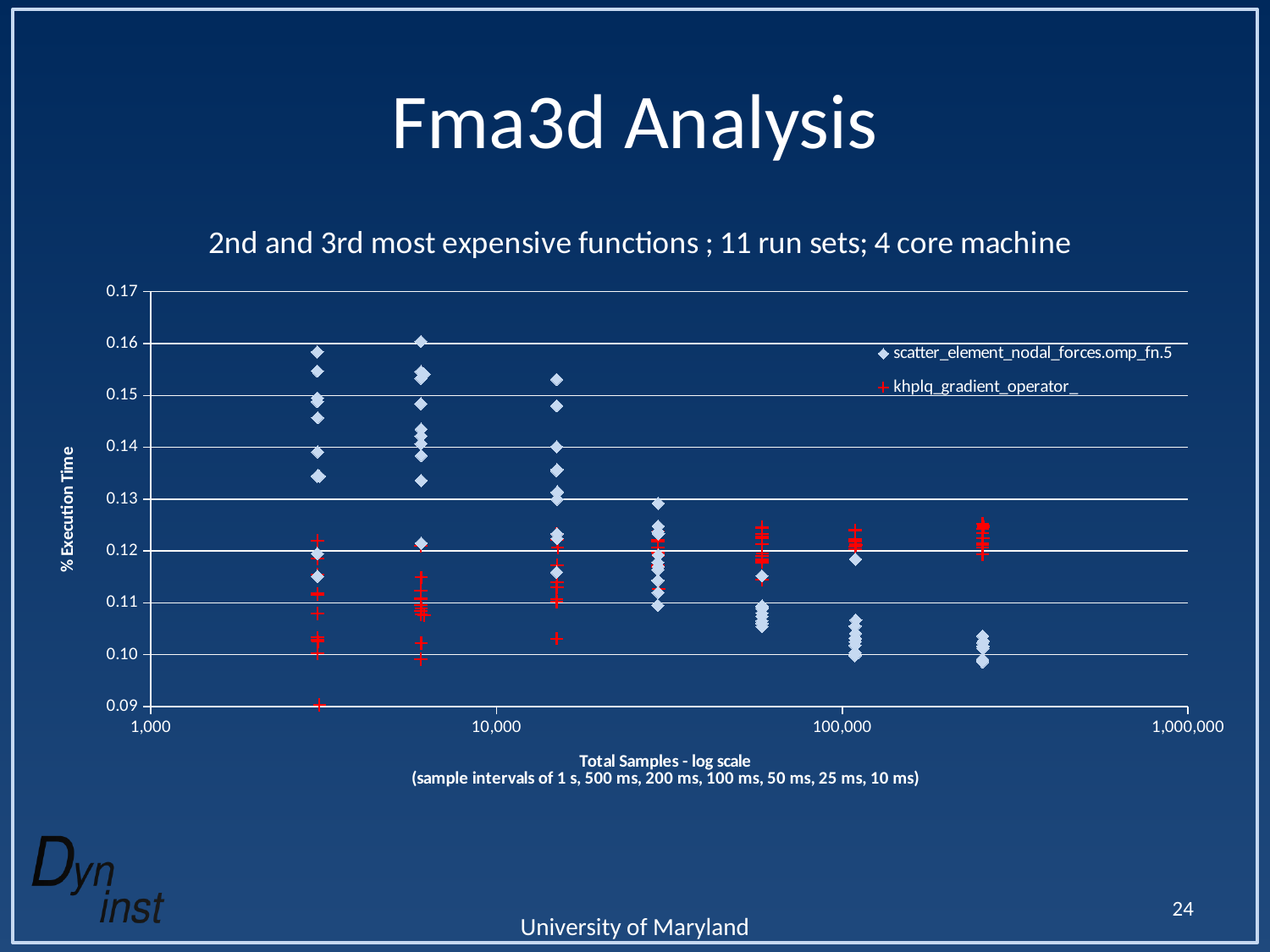
Do the values for khplq_gradient_operator_ generally rise or fall as Total Samples increases along the x axis? rise What is the title of the chart's vertical axis? % Execution Time Which series contains the lowest plotted point on the chart? khplq_gradient_operator_ Which series contains the highest plotted point on the chart? scatter_element_nodal_forces.omp_fn.5 How many labelled tick marks are shown on the chart's x axis? 4 What kind of chart is shown on the slide? scatter chart Is the highest value for khplq_gradient_operator_ greater or less than 0.13? less How many series does the chart's legend list? 2 Do the values for scatter_element_nodal_forces.omp_fn.5 generally rise or fall as Total Samples increases along the x axis? fall Is the lowest value for khplq_gradient_operator_ greater or less than 0.10? less What are the two series named in the chart's legend? scatter_element_nodal_forces.omp_fn.5 and khplq_gradient_operator_ Is the highest value for scatter_element_nodal_forces.omp_fn.5 greater or less than 0.15? greater